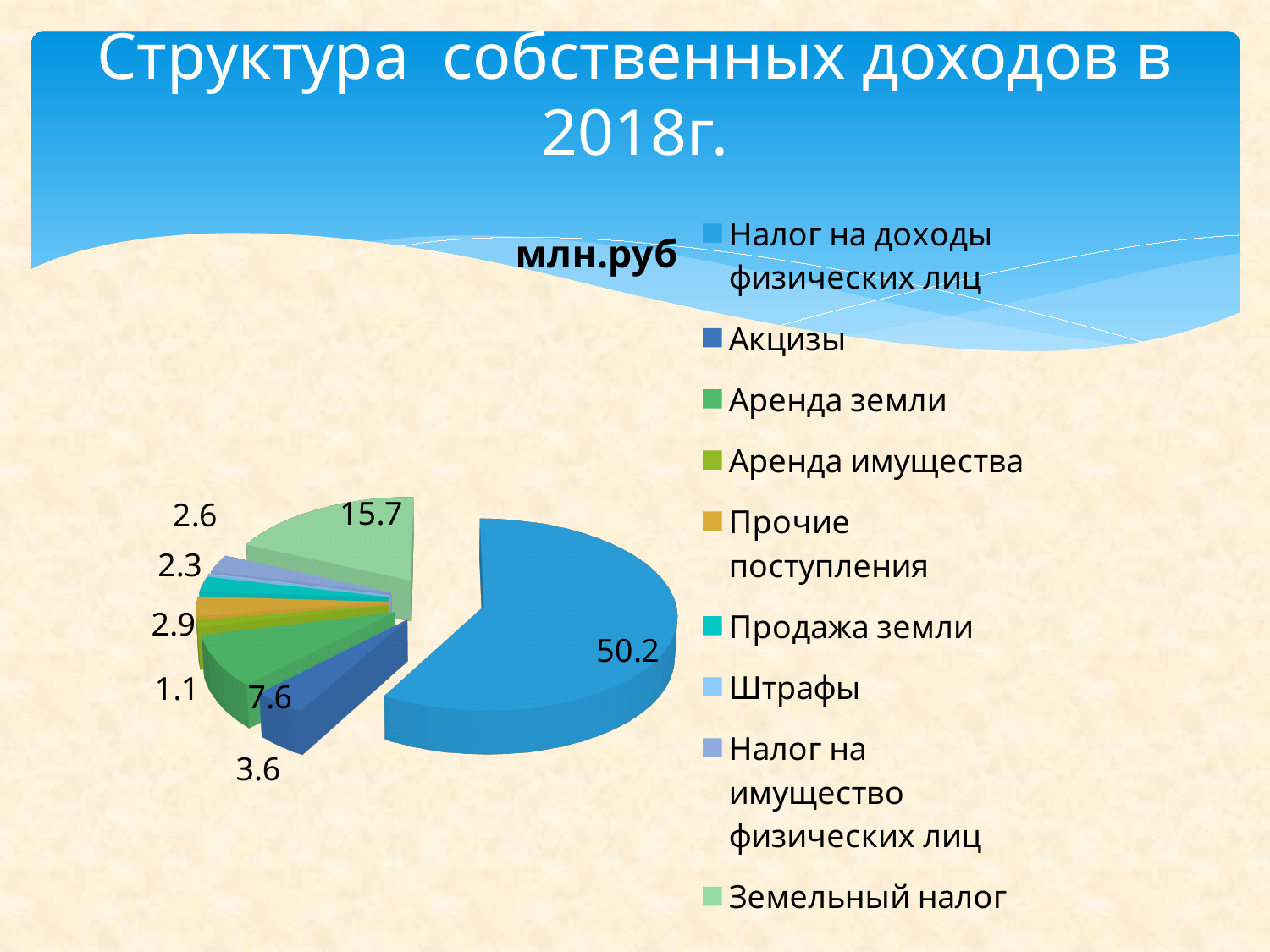
What is the value for Налог на доходы физических лиц? 50.2 What is the value for Земельный налог? 15.7 Which is larger, Аренда земли or Акцизы? Аренда земли What is the value for Аренда земли? 7.6 What is the value for Аренда имущества? 1.1 Which category has the largest slice of the pie? Налог на доходы физических лиц What kind of chart is shown on the slide? pie chart How many categories does the legend of the pie chart list? 9 What unit label is shown above the pie chart? млн.руб What is the value for Прочие поступления? 2.9 What is the value for Акцизы? 3.6 What is the difference between the values for Налог на доходы физических лиц and Земельный налог? 34.5